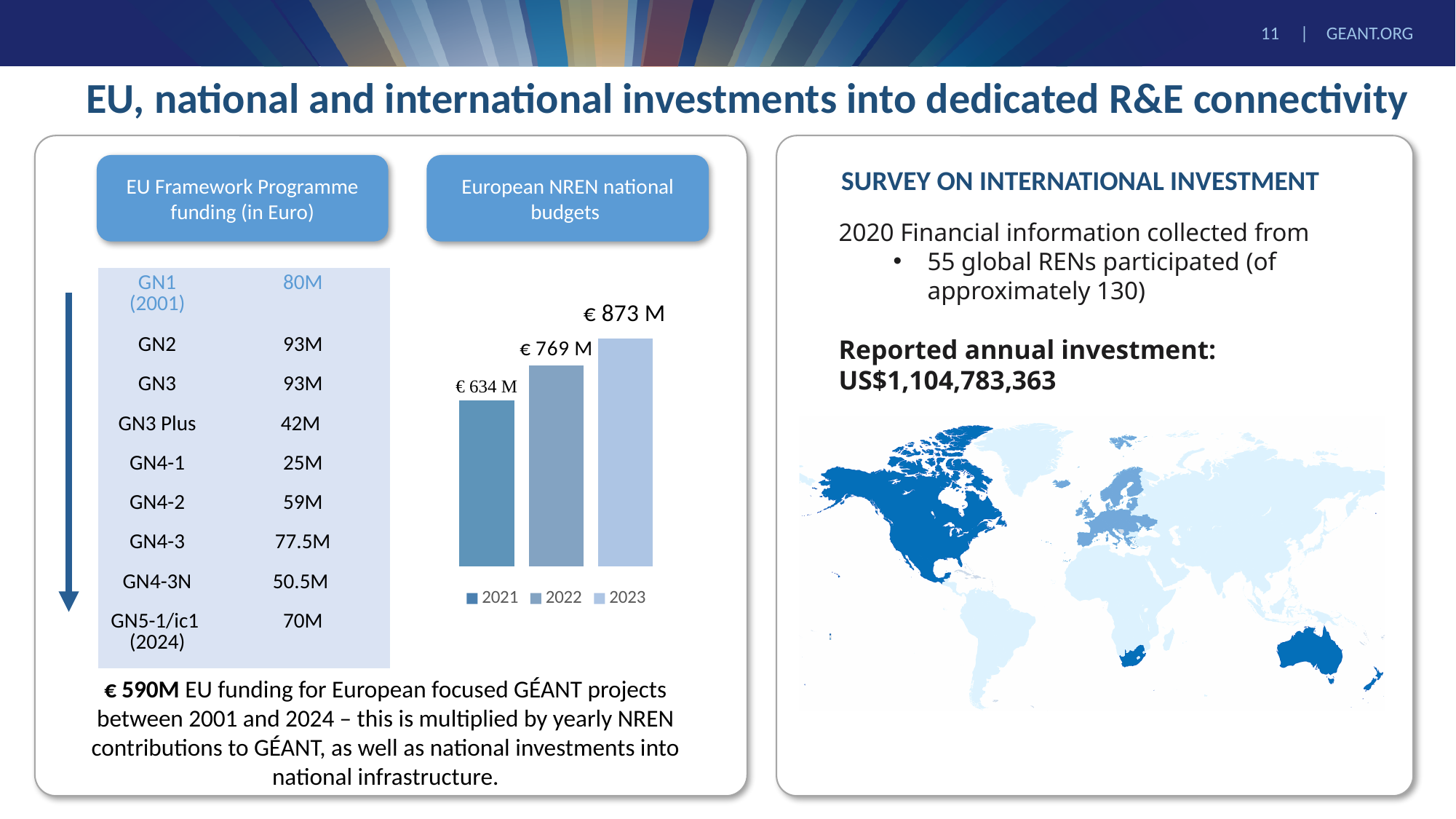
In the European NREN national budgets chart, what is the difference between the 2022 and 2021 values? € 135 M In the European NREN national budgets chart, which is larger, the value for 2022 or the value for 2023? 2023 In the European NREN national budgets chart, what is the value for 2021? € 634 M In the European NREN national budgets chart, what is the value for 2022? € 769 M In the European NREN national budgets chart, which year has the highest budget? 2023 How many entries does the legend of the European NREN national budgets chart list? 3 In the European NREN national budgets chart, which year has the lowest budget? 2021 What type of chart is used for the European NREN national budgets? Bar chart In the European NREN national budgets chart, what is the value for 2023? € 873 M In the European NREN national budgets chart, what is the difference between the 2023 and 2021 values? € 239 M How many bars are shown in the European NREN national budgets chart? 3 In the European NREN national budgets chart, do the values rise or fall from 2021 to 2023? Rise